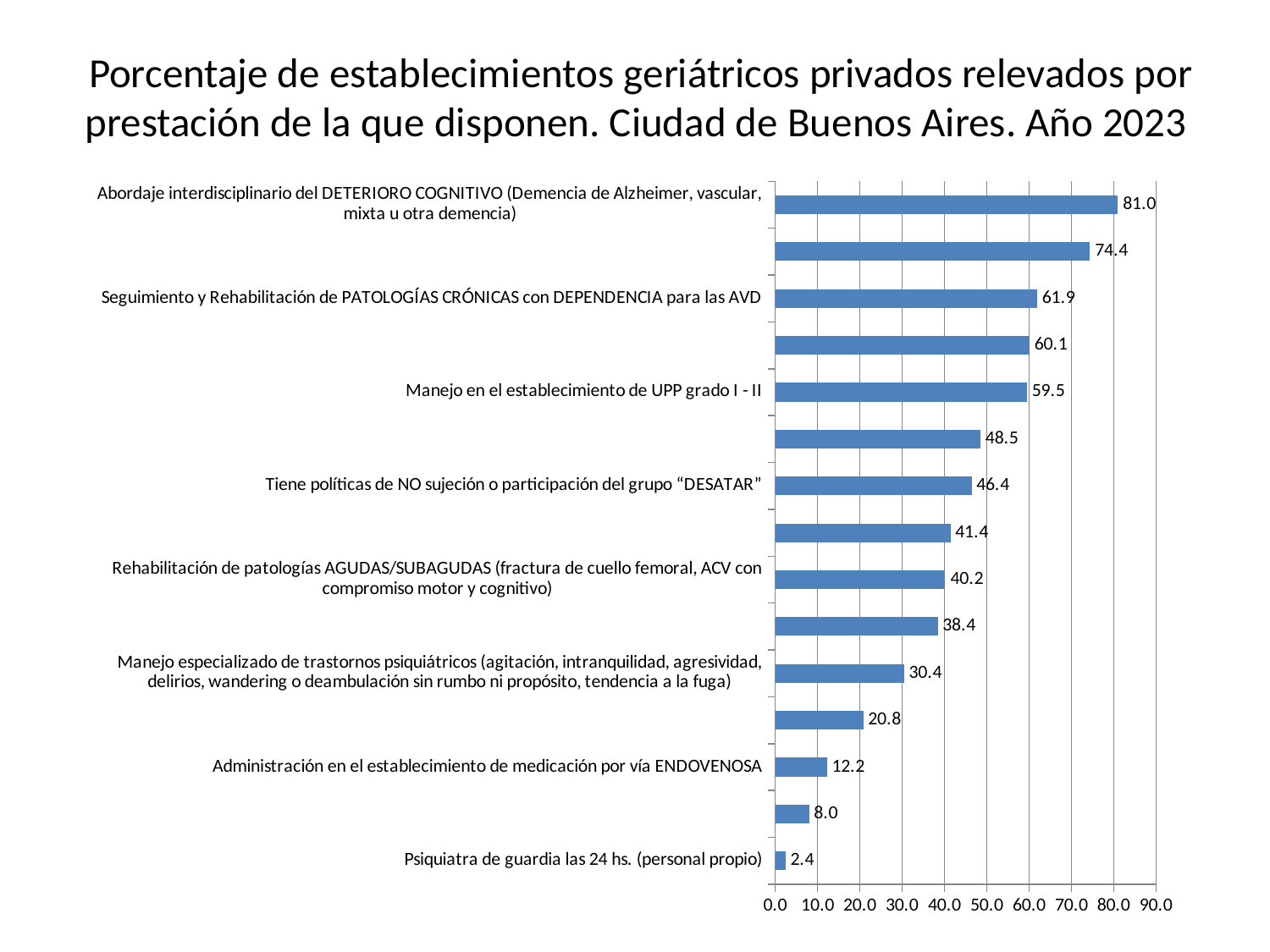
What is the difference between the highest value (81.0) and the lowest value (2.4)? 78.6 Which category has the highest value? Abordaje interdisciplinario del DETERIORO COGNITIVO (Demencia de Alzheimer, vascular, mixta u otra demencia) Is the value for "Manejo especializado de trastornos psiquiátricos (agitación, intranquilidad, agresividad, delirios, wandering o deambulación sin rumbo ni propósito, tendencia a la fuga)" greater or less than 40.0? less What is the difference between the value for "Seguimiento y Rehabilitación de PATOLOGÍAS CRÓNICAS con DEPENDENCIA para las AVD" and the value for "Manejo en el establecimiento de UPP grado I - II"? 2.4 Which category has the lowest value? Psiquiatra de guardia las 24 hs. (personal propio) Which is larger: the value for "Tiene políticas de NO sujeción o participación del grupo “DESATAR”" or the value for "Rehabilitación de patologías AGUDAS/SUBAGUDAS (fractura de cuello femoral, ACV con compromiso motor y cognitivo)"? Tiene políticas de NO sujeción o participación del grupo “DESATAR” What type of chart is shown on the slide? bar chart What is the value for "Psiquiatra de guardia las 24 hs. (personal propio)"? 2.4 What is the value for "Abordaje interdisciplinario del DETERIORO COGNITIVO (Demencia de Alzheimer, vascular, mixta u otra demencia)"? 81.0 What is the value for "Administración en el establecimiento de medicación por vía ENDOVENOSA"? 12.2 What is the value for "Manejo en el establecimiento de UPP grado I - II"? 59.5 How many bars are plotted in the chart? 15